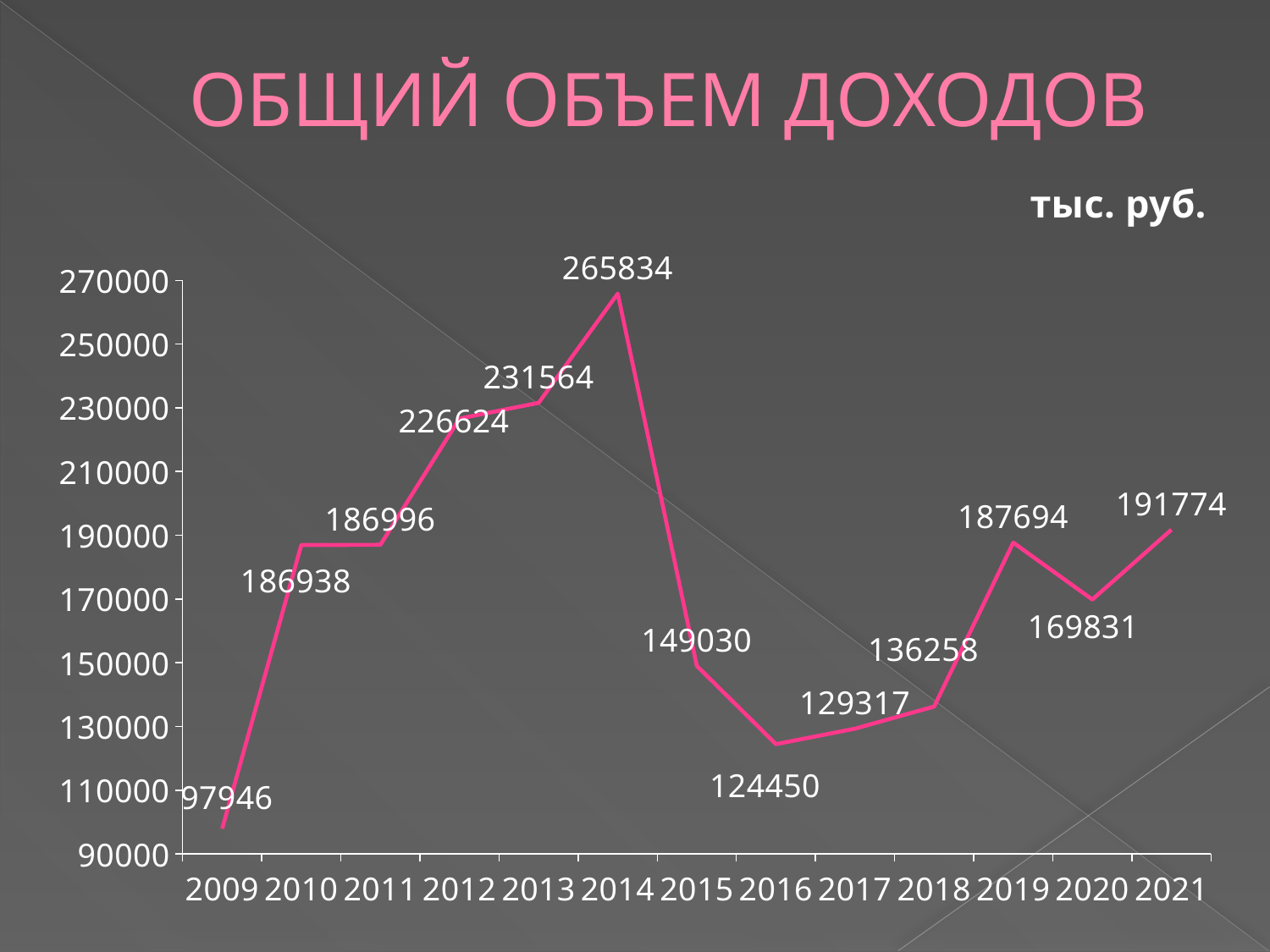
How many years are plotted on the chart? 13 Which year has the highest value? 2014 What is the value for 2014? 265834 What is the difference between the values for 2014 and 2015? 116804 What type of chart is shown on the slide? line chart What is the value for 2017? 129317 Which is larger, the value for 2019 or the value for 2020? 2019 What is the value for 2009? 97946 What is the value for 2021? 191774 Which year has the lowest value? 2009 What unit is indicated for the values on the chart? тыс. руб. Do the values rise or fall from 2014 to 2016? fall